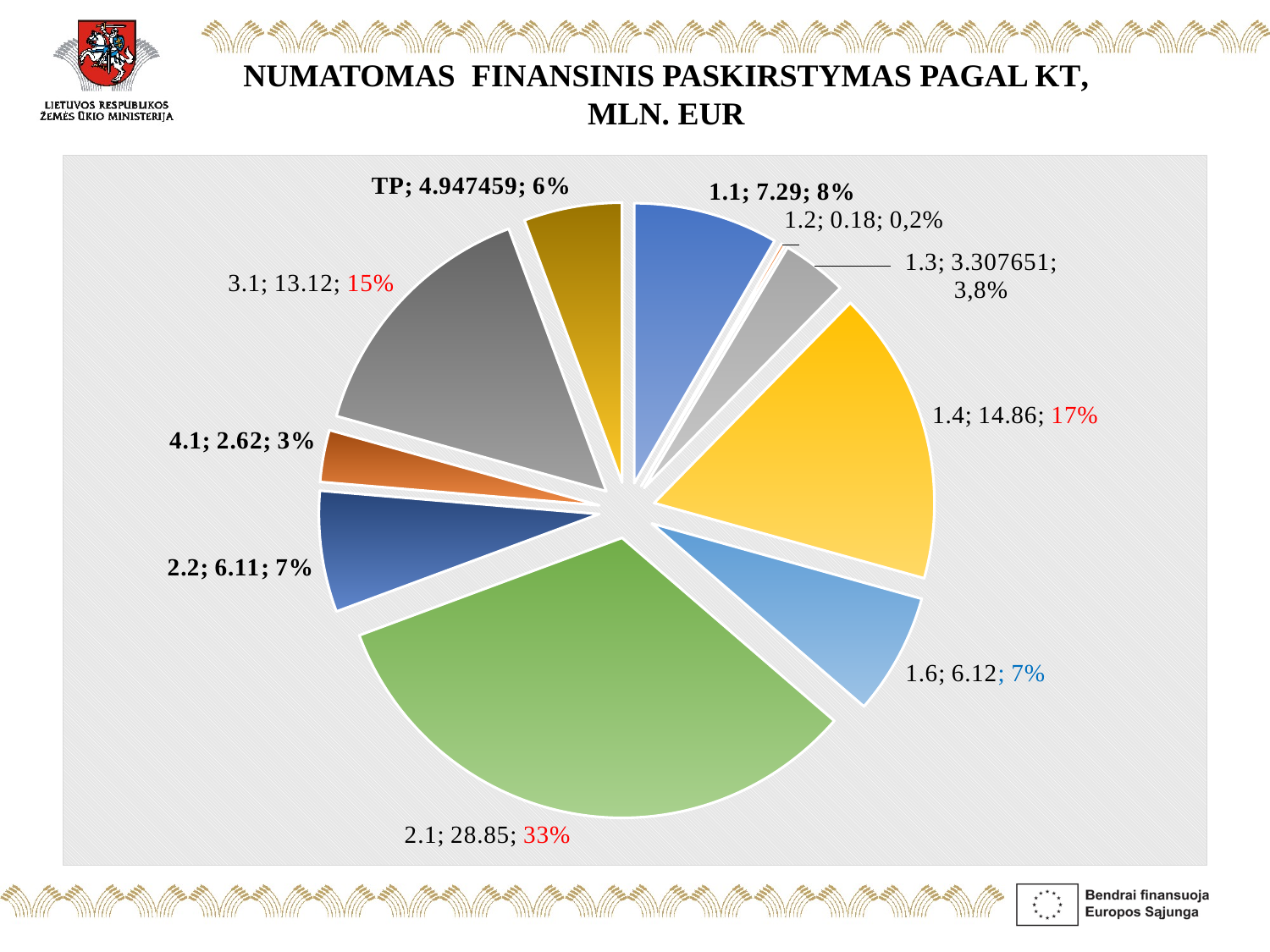
How many slices does the pie chart have? 10 What type of chart is shown on the slide? pie chart What is the value for category 2.1? 28.85 Which category has the largest slice of the pie? 2.1 What is the difference between the values for 2.1 and 1.4? 13.99 Which category has the smallest slice of the pie? 1.2 What is the value for category 1.4? 14.86 What is the value for category 3.1? 13.12 Which is larger, the value for 1.1 or the value for 2.2? 1.1 What is the value for category TP? 4.947459 What share of the pie does category 1.4 represent? 17% What share of the pie does category 3.1 represent? 15%